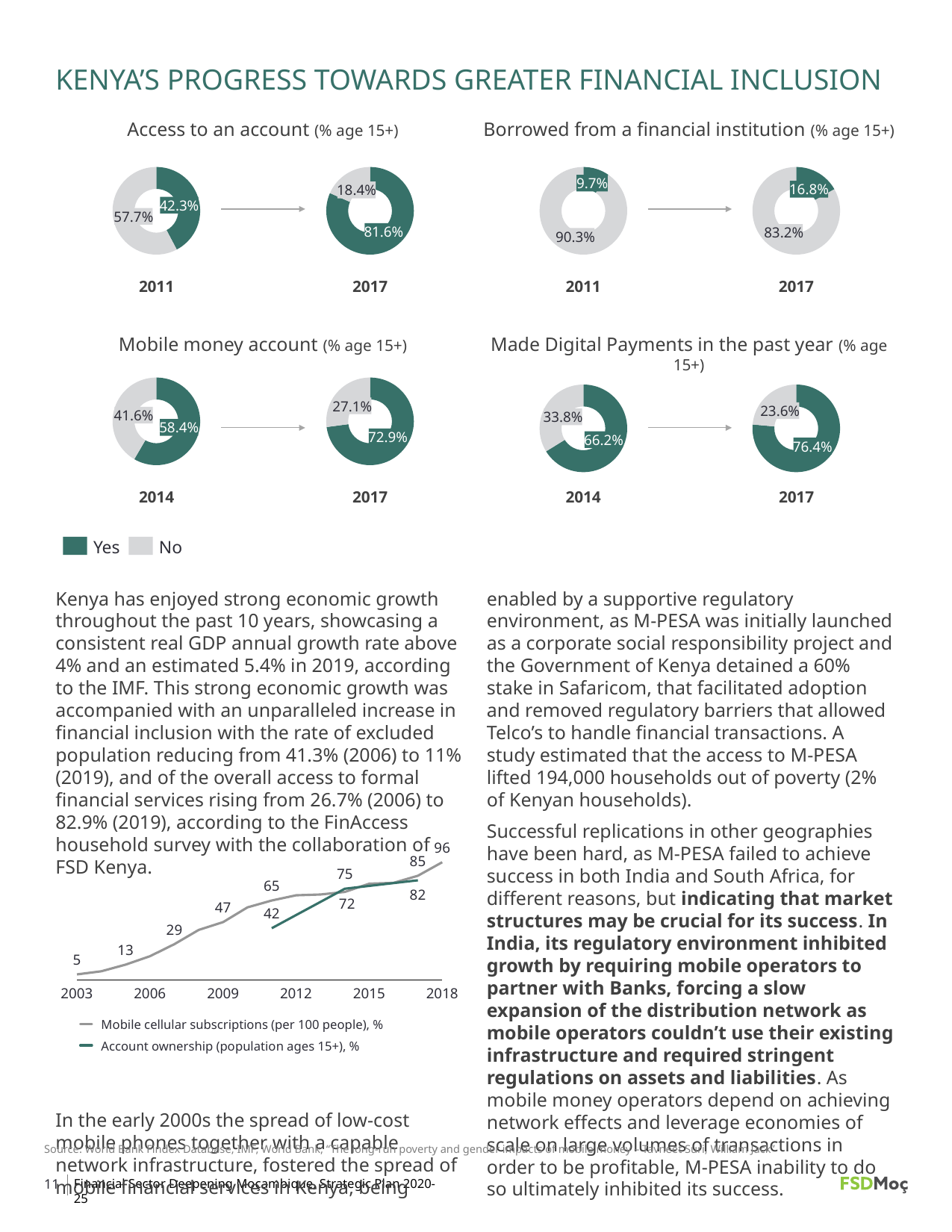
In the 'Access to an account' chart, what percentage answered No in 2011? 57.7% In the 'Borrowed from a financial institution' chart, what is the difference between the Yes share in 2017 and the Yes share in 2011? 7.1 percentage points In the 'Access to an account' chart, what percentage answered Yes in 2017? 81.6% In the line chart at the bottom left, what is the value of Mobile cellular subscriptions (per 100 people) in 2003? 5 In the 'Made Digital Payments in the past year' chart, what percentage answered Yes in 2017? 76.4% In the line chart at the bottom left, what is the highest value shown for Mobile cellular subscriptions (per 100 people)? 96 In the 'Mobile money account' chart, what percentage answered Yes in 2014? 58.4% What kind of charts are used to show the Yes/No shares in the top part of the slide? Donut (pie) charts In the line chart at the bottom left, how many series does the legend list? 2 In the 'Borrowed from a financial institution' chart, what percentage answered Yes in 2011? 9.7% In the 'Made Digital Payments in the past year' chart, which year has the larger Yes share, 2014 or 2017? 2017 In the 'Mobile money account' chart, what percentage answered No in 2017? 27.1%